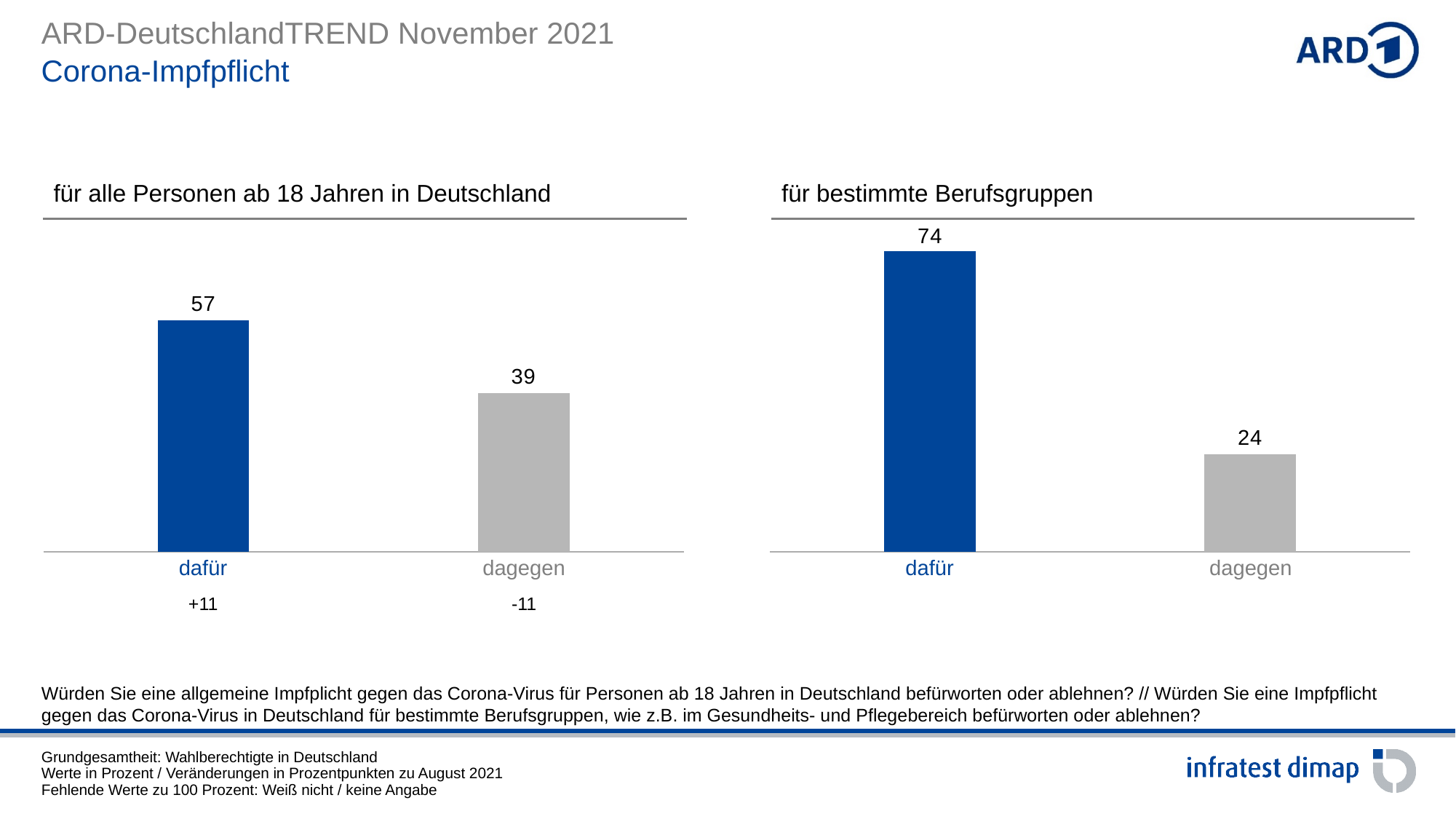
In the chart 'für bestimmte Berufsgruppen', which category has the highest value? dafür In the chart 'für alle Personen ab 18 Jahren in Deutschland', what is the value for 'dafür'? 57 In the chart 'für bestimmte Berufsgruppen', what is the difference between 'dafür' and 'dagegen'? 50 In the chart 'für alle Personen ab 18 Jahren in Deutschland', what is the value for 'dagegen'? 39 In the chart 'für bestimmte Berufsgruppen', what is the value for 'dagegen'? 24 In the chart 'für alle Personen ab 18 Jahren in Deutschland', what is the difference between 'dafür' and 'dagegen'? 18 In the chart 'für alle Personen ab 18 Jahren in Deutschland', what change in percentage points compared to August 2021 is shown below 'dafür'? +11 How many categories are shown in the chart 'für alle Personen ab 18 Jahren in Deutschland'? 2 In the chart 'für bestimmte Berufsgruppen', what is the value for 'dafür'? 74 In the chart 'für alle Personen ab 18 Jahren in Deutschland', which category has the lowest value? dagegen Is the value for 'dafür' larger in the chart 'für alle Personen ab 18 Jahren in Deutschland' or in the chart 'für bestimmte Berufsgruppen'? für bestimmte Berufsgruppen What kind of chart is the chart 'für bestimmte Berufsgruppen'? bar chart